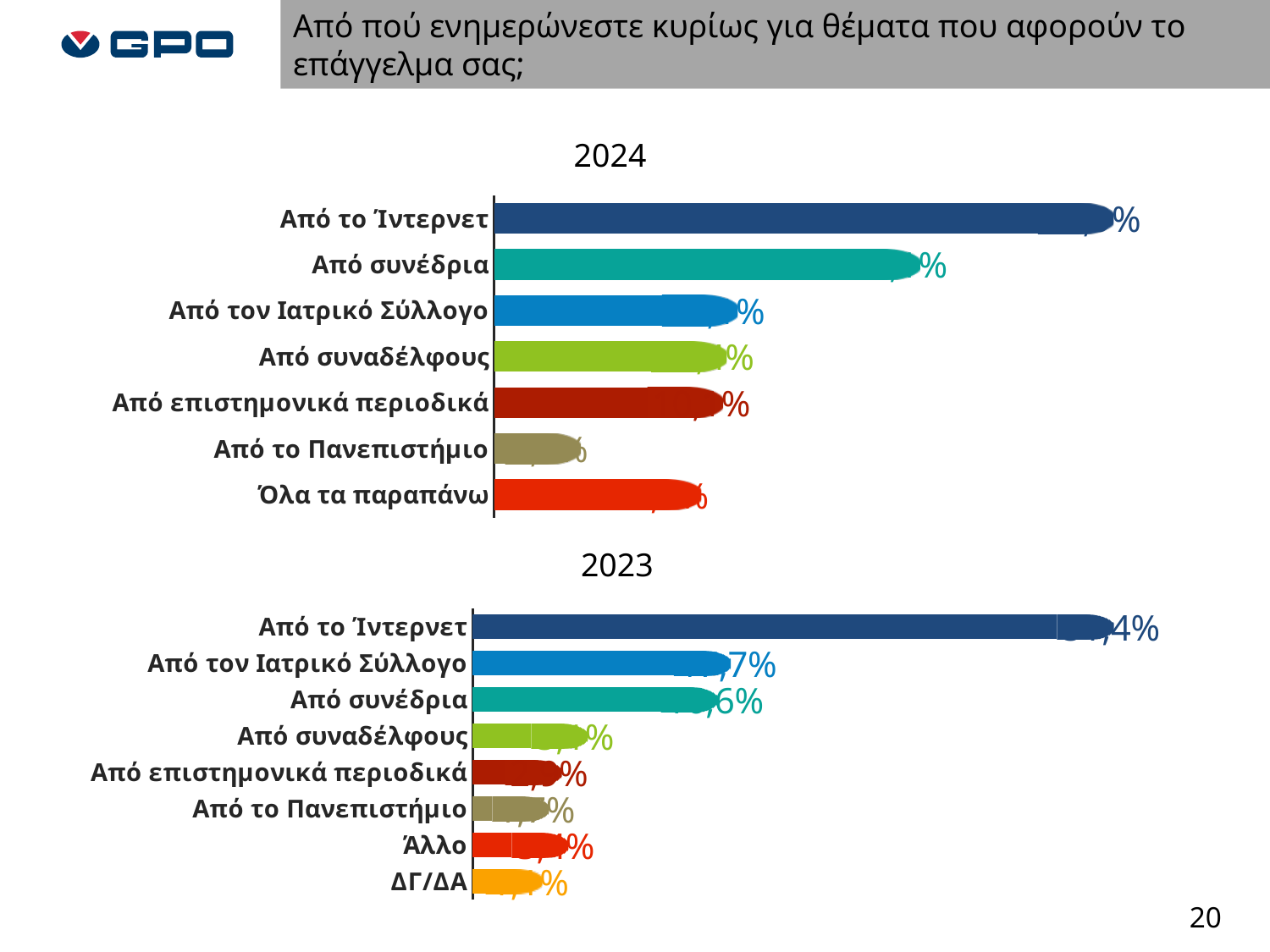
In the 2024 chart, which is larger: the value for Από συνέδρια or for Από τον Ιατρικό Σύλλογο? Από συνέδρια In the 2024 chart, which is larger: the value for Όλα τα παραπάνω or for Από το Πανεπιστήμιο? Όλα τα παραπάνω In the 2023 chart, which category has the lowest value? ΔΓ/ΔΑ How many categories are shown in the 2024 chart? 7 In the 2024 chart, which category has the highest value? Από το Ίντερνετ In the 2023 chart, which is larger: the value for Από το Ίντερνετ or for Από τον Ιατρικό Σύλλογο? Από το Ίντερνετ What is the title of the upper chart on the slide? 2024 How many categories are shown in the 2023 chart? 8 What kind of chart is the 2023 chart? Bar chart In the 2024 chart, which category has the lowest value? Από το Πανεπιστήμιο In the 2023 chart, which category has the highest value? Από το Ίντερνετ